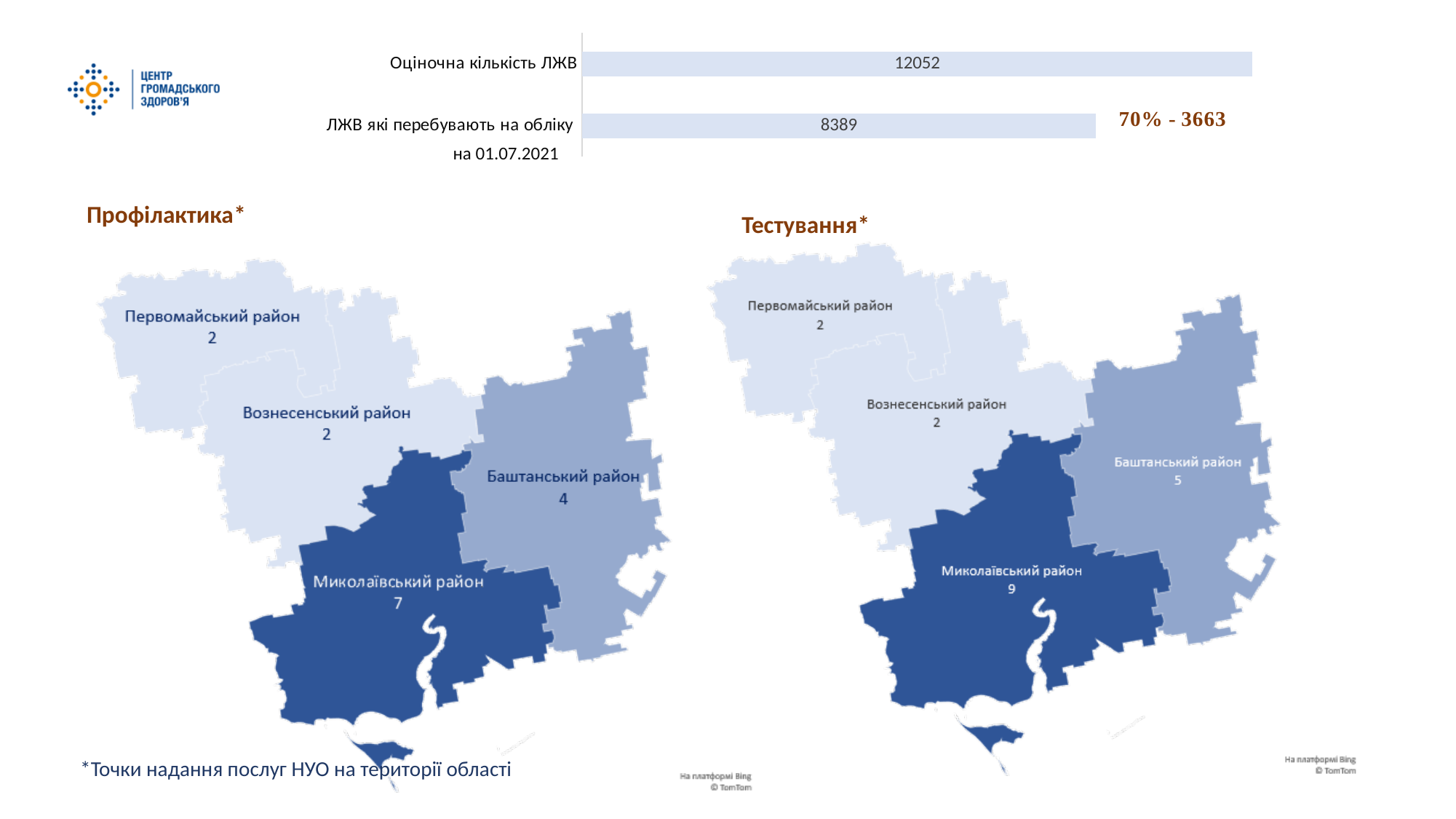
How many bars are in the bar chart at the top of the slide? 2 In the "Тестування" map, which district has the highest value? Миколаївський район In the bar chart at the top of the slide, what is the value for "ЛЖВ які перебувають на обліку на 01.07.2021"? 8389 In the "Профілактика" map, which district has the lowest value? Первомайський район and Вознесенський район (2 each) In the bar chart at the top of the slide, what is the value for "Оціночна кількість ЛЖВ"? 12052 How many districts are labelled with values in the "Профілактика" map? 4 In the bar chart at the top of the slide, which category has the larger value: "Оціночна кількість ЛЖВ" or "ЛЖВ які перебувають на обліку на 01.07.2021"? Оціночна кількість ЛЖВ In the bar chart at the top of the slide, what is the difference between the estimated number of PLHIV (12052) and those registered (8389)? 3663 In the "Тестування" map, what is the value for Баштанський район? 5 What kind of chart is shown at the top of the slide? Bar chart What is the difference between the value for Миколаївський район in the "Тестування" map and in the "Профілактика" map? 2 In the "Профілактика" map, what is the value for Миколаївський район? 7